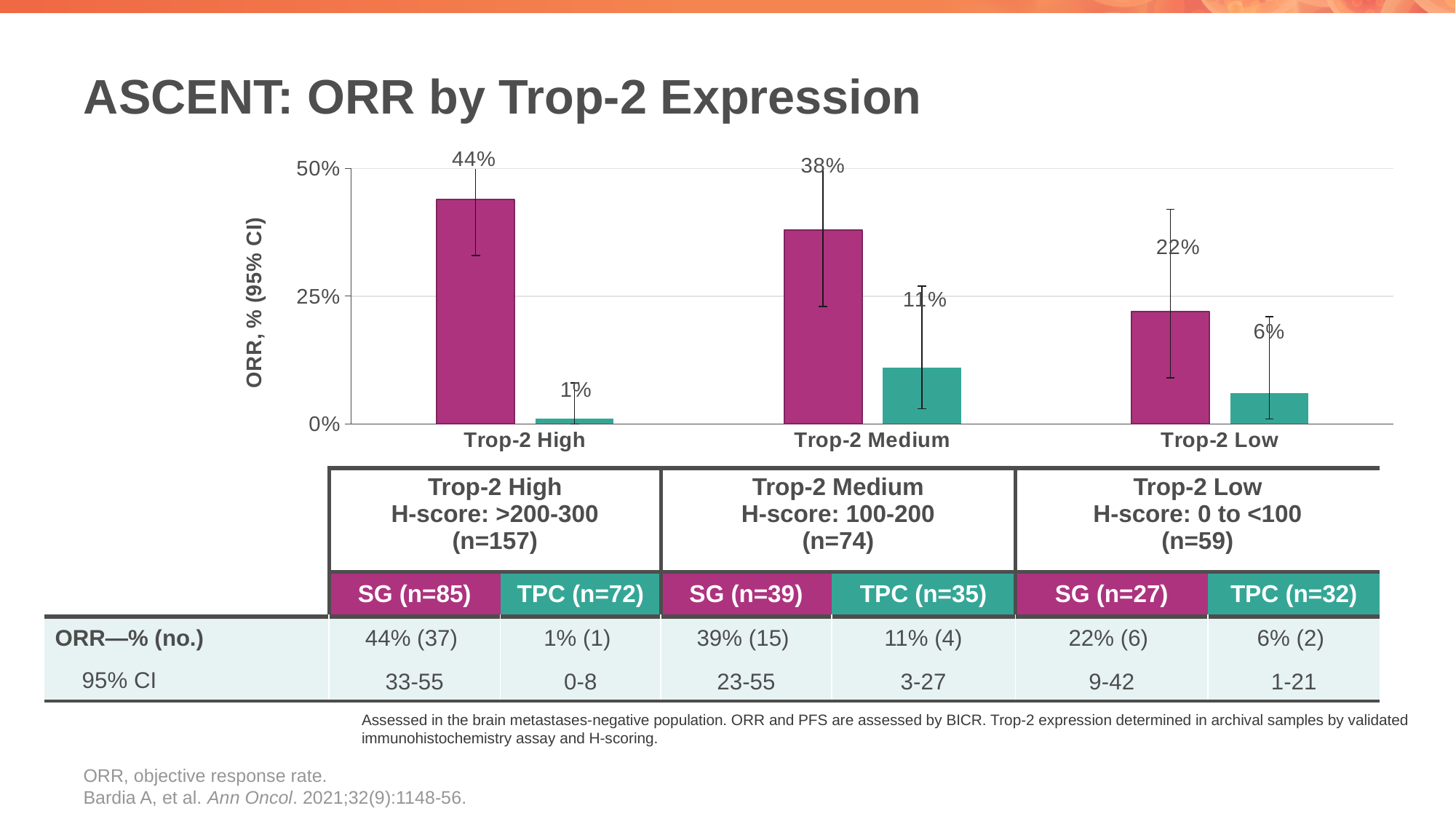
Which bar in the chart has the lowest ORR? TPC, Trop-2 High (1%) What is the ORR for TPC in the Trop-2 Low group according to the chart's data label? 6% Does the SG ORR decrease or increase moving from Trop-2 High to Trop-2 Low along the x axis? decrease What is the ORR for SG in the Trop-2 Low group according to the chart's data label? 22% What is the label of the chart's y axis? ORR, % (95% CI) What is the ORR for TPC in the Trop-2 High group according to the chart's data label? 1% How many Trop-2 expression categories are shown on the x axis of the chart? 3 What is the ORR for TPC in the Trop-2 Medium group according to the chart's data label? 11% What is the difference between the SG and TPC ORR data labels in the Trop-2 Low group? 16% What type of chart is shown on the slide? bar chart Which bar in the chart has the highest ORR? SG, Trop-2 High (44%) What is the ORR for SG in the Trop-2 High group according to the chart's data label? 44%